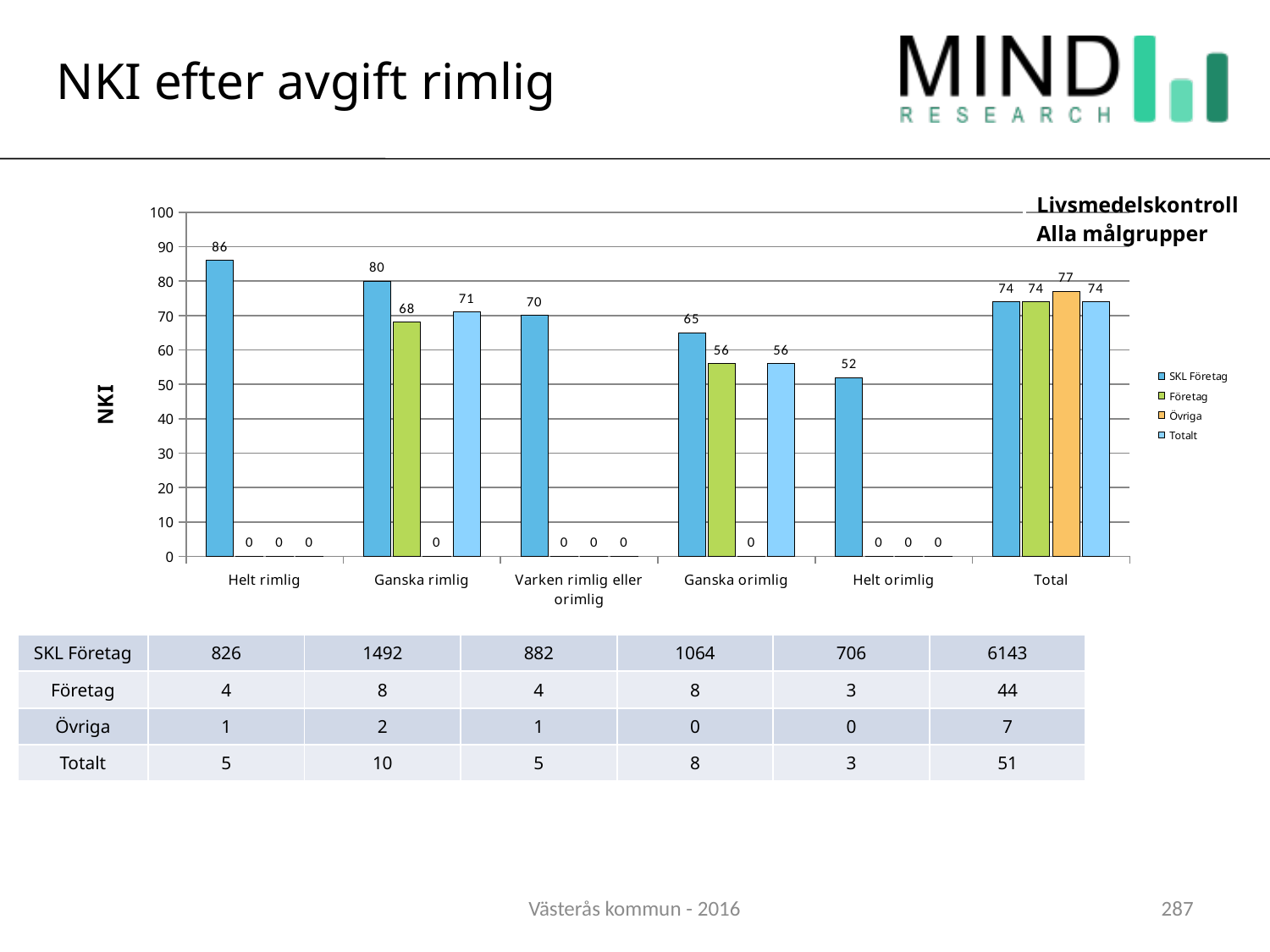
What kind of chart is shown? Bar chart How many series does the legend list? 4 How many categories are shown on the x axis? 6 What is the Företag value for Ganska rimlig? 68 What is the SKL Företag value for Helt rimlig? 86 Which category has the lowest SKL Företag value? Helt orimlig What is the Totalt value for Ganska orimlig? 56 What is the label on the y axis? NKI Which category has the highest SKL Företag value? Helt rimlig What is the difference between the SKL Företag values for Helt rimlig and Helt orimlig? 34 What is the Övriga value for Total? 77 Which is larger, the SKL Företag value for Ganska rimlig or the Totalt value for Ganska rimlig? SKL Företag